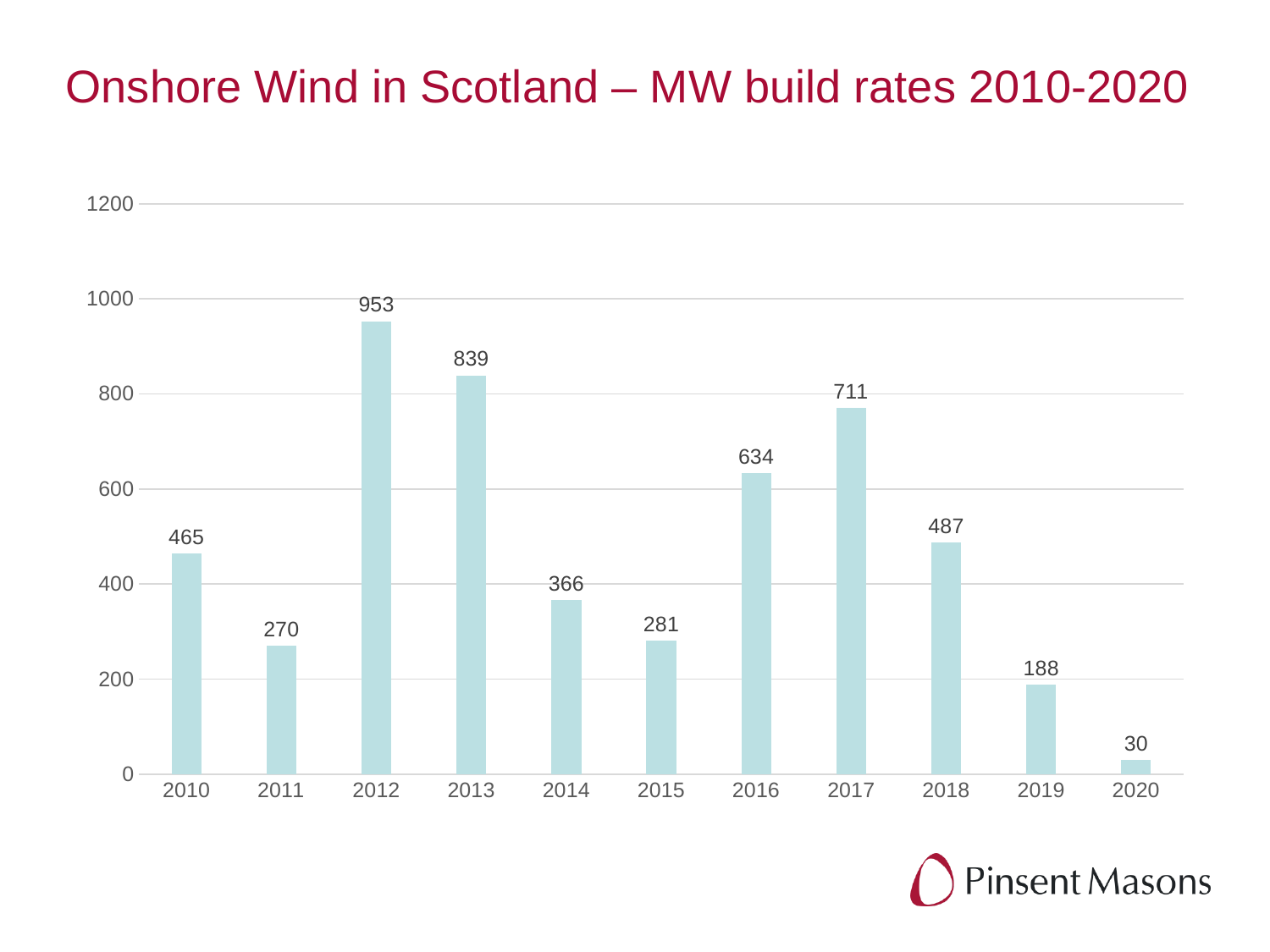
What is the difference between the values for 2016 and 2015? 353 What kind of chart is shown on the slide? bar chart Which is larger, the value for 2010 or the value for 2018? 2018 What is the value for 2017? 711 What is the value for 2012? 953 What is the difference between the values for 2012 and 2013? 114 How many years are shown on the x axis? 11 Is the value for 2014 greater or less than 400? less What is the title of the chart? Onshore Wind in Scotland – MW build rates 2010-2020 Which year has the lowest value? 2020 Which year has the highest value? 2012 What is the value for 2020? 30